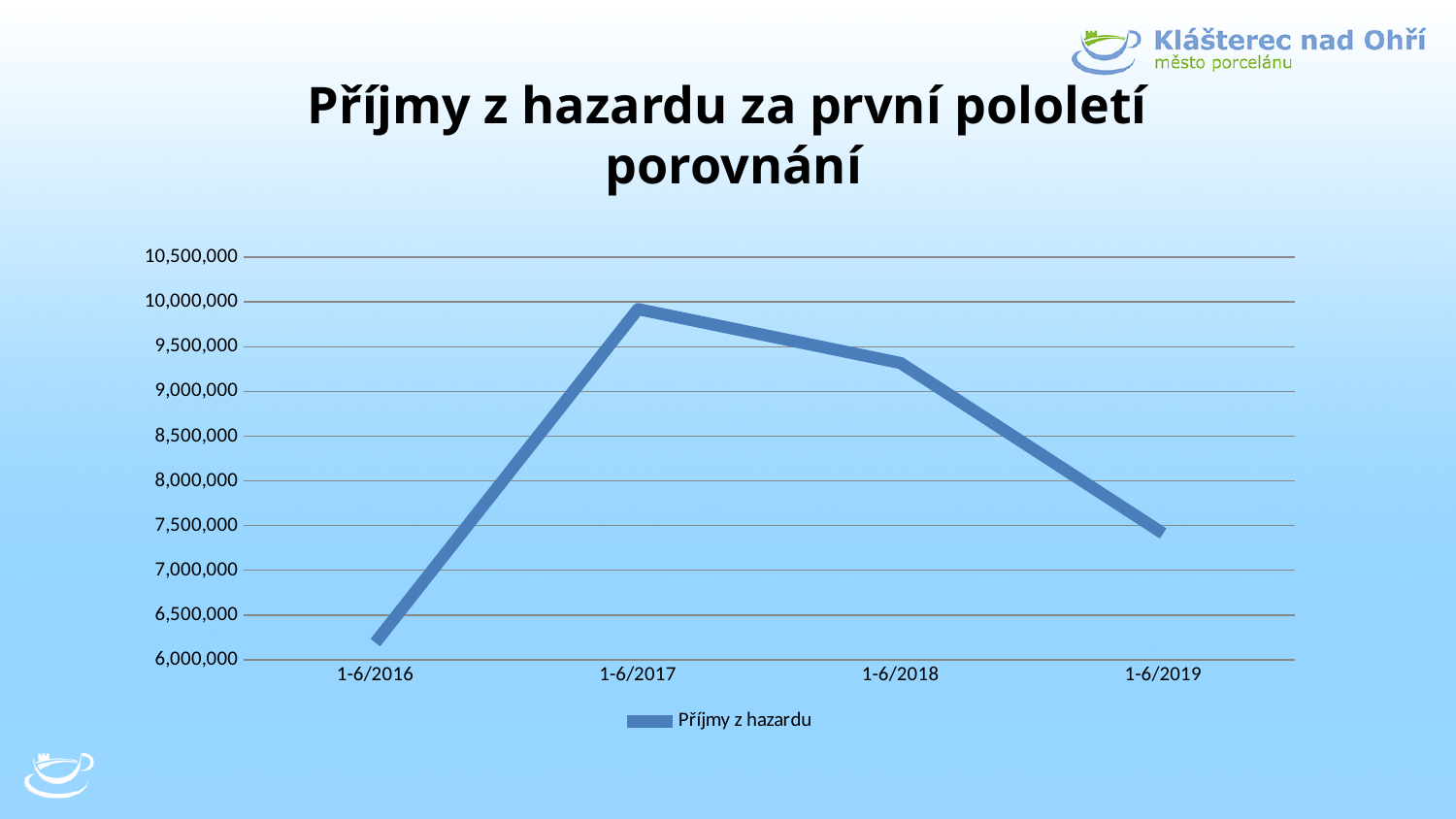
Is the value for 1-6/2018 greater or less than 9,000,000? greater Is the value for 1-6/2016 greater or less than 6,500,000? less How many series does the legend list? 1 What is the name of the series shown in the legend? Příjmy z hazardu Do the values rise or fall from 1-6/2017 to 1-6/2019? fall Is the value for 1-6/2017 greater or less than 9,500,000? greater What kind of chart is shown on the slide? line chart Which period has the lowest value? 1-6/2016 Which is larger, the value for 1-6/2018 or the value for 1-6/2019? 1-6/2018 Which period has the highest value? 1-6/2017 How many points are plotted on the line? 4